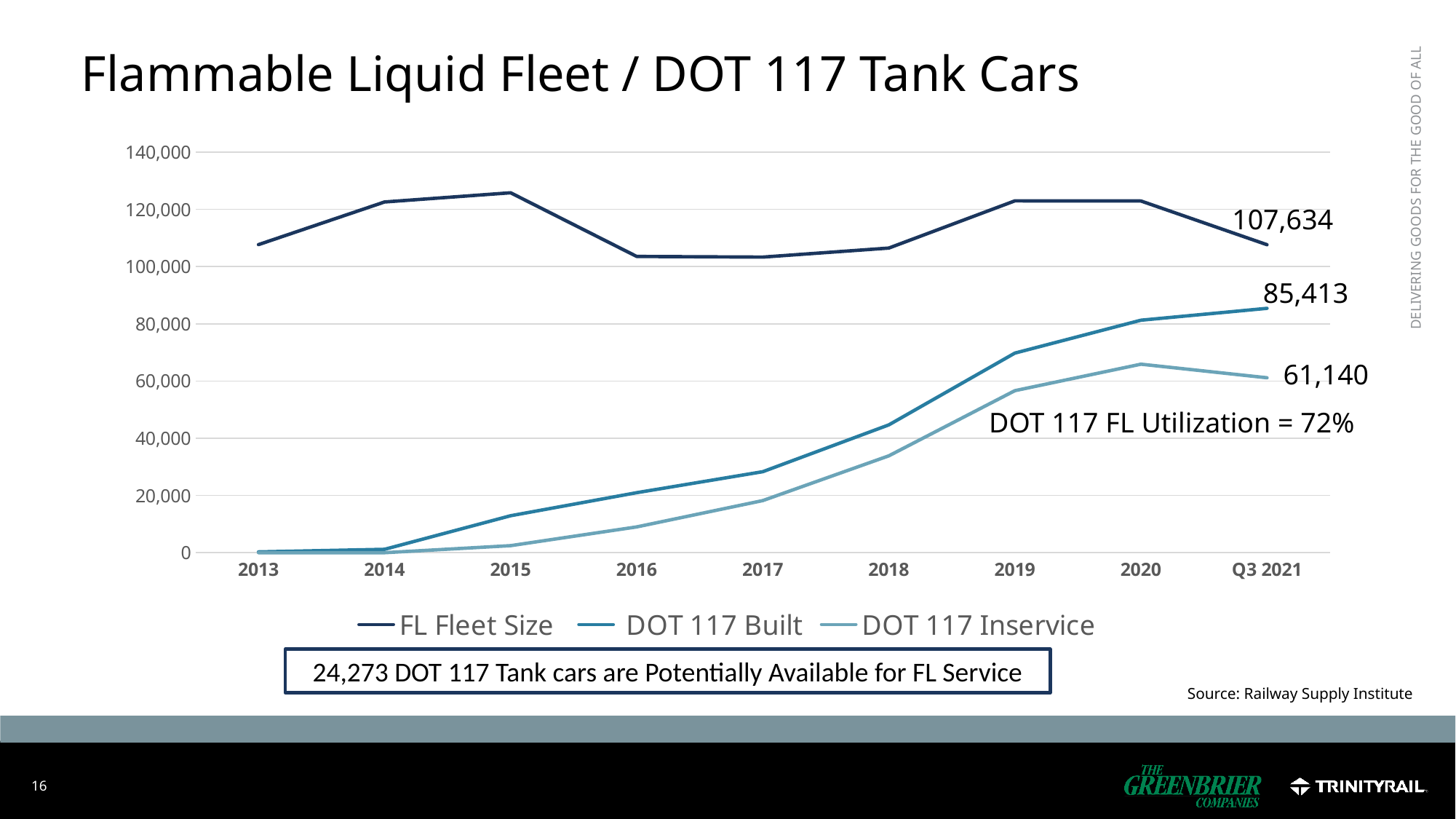
How many time points are shown on the x axis? 9 What is the DOT 117 Built value labelled at Q3 2021? 85,413 At Q3 2021, which is larger: DOT 117 Built or DOT 117 Inservice? DOT 117 Built What is the DOT 117 Inservice value labelled at Q3 2021? 61,140 At Q3 2021, what is the difference between FL Fleet Size and DOT 117 Built? 22,221 Is the DOT 117 Built value for 2019 greater or less than 60,000? greater At Q3 2021, what is the difference between DOT 117 Built and DOT 117 Inservice? 24,273 What kind of chart is shown on the slide? line chart Is the FL Fleet Size value for 2015 greater or less than 120,000? greater How many series does the legend list? 3 What is the FL Fleet Size value labelled at Q3 2021? 107,634 Which series has the highest value at Q3 2021? FL Fleet Size